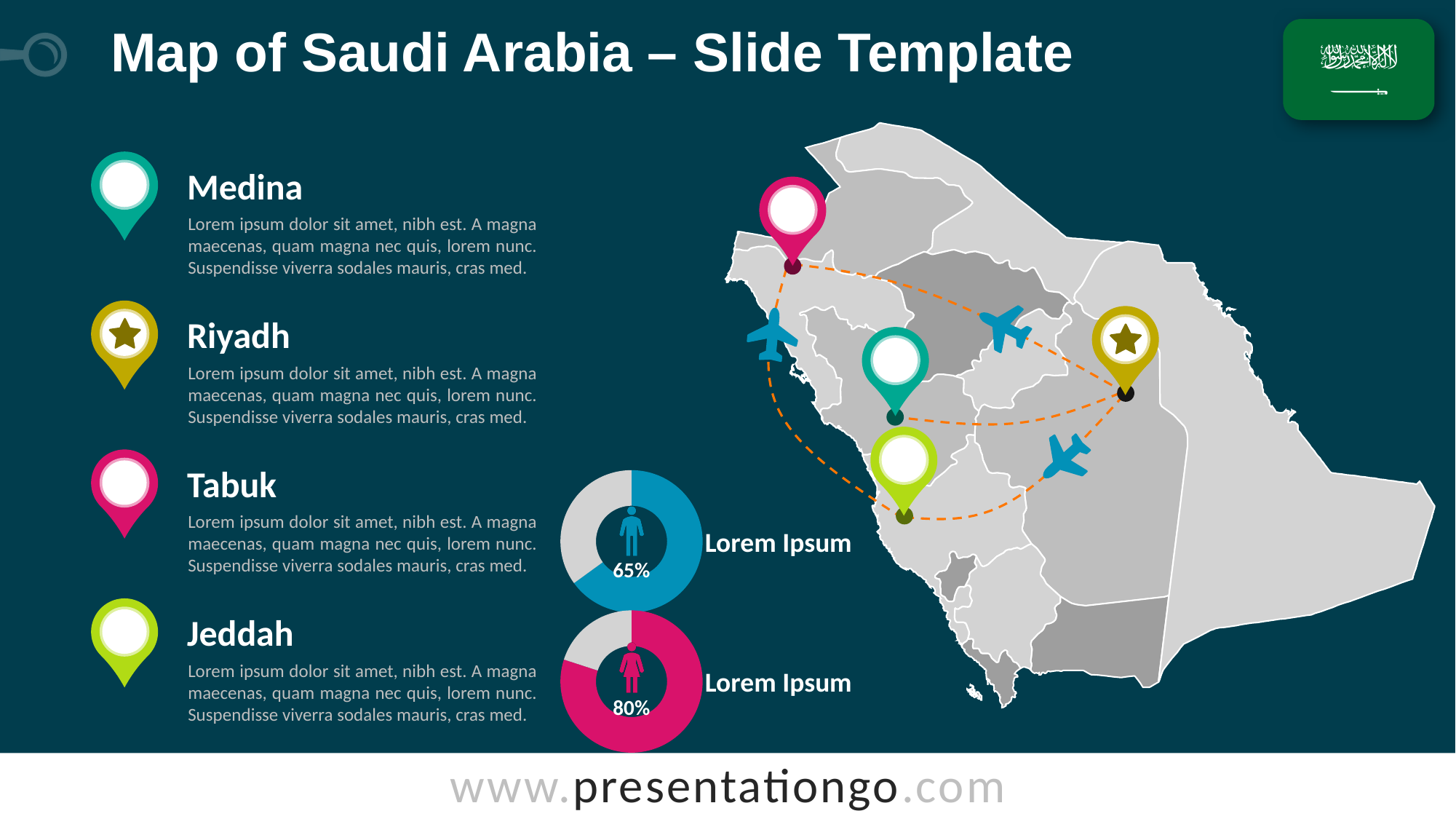
What share of the upper donut chart is left grey (unfilled)? 35% Is the value in the upper donut chart greater or less than 50%? greater What kind of chart is used to display the 65% and 80% values? donut chart What share of the lower donut chart is not filled in pink? 20% Is the value in the lower donut chart greater or less than 75%? greater What colour is the filled portion of the upper donut chart showing 65%? blue Which of the two donut charts shows the larger percentage, the upper (blue) one or the lower (pink) one? the lower (pink) one What label text appears to the right of each donut chart? Lorem Ipsum What is the difference between the percentage in the lower donut chart and the percentage in the upper donut chart? 15% What value is shown in the upper donut chart with the male icon? 65% What value is shown in the lower donut chart with the female icon? 80% How many donut charts are shown on the slide? 2